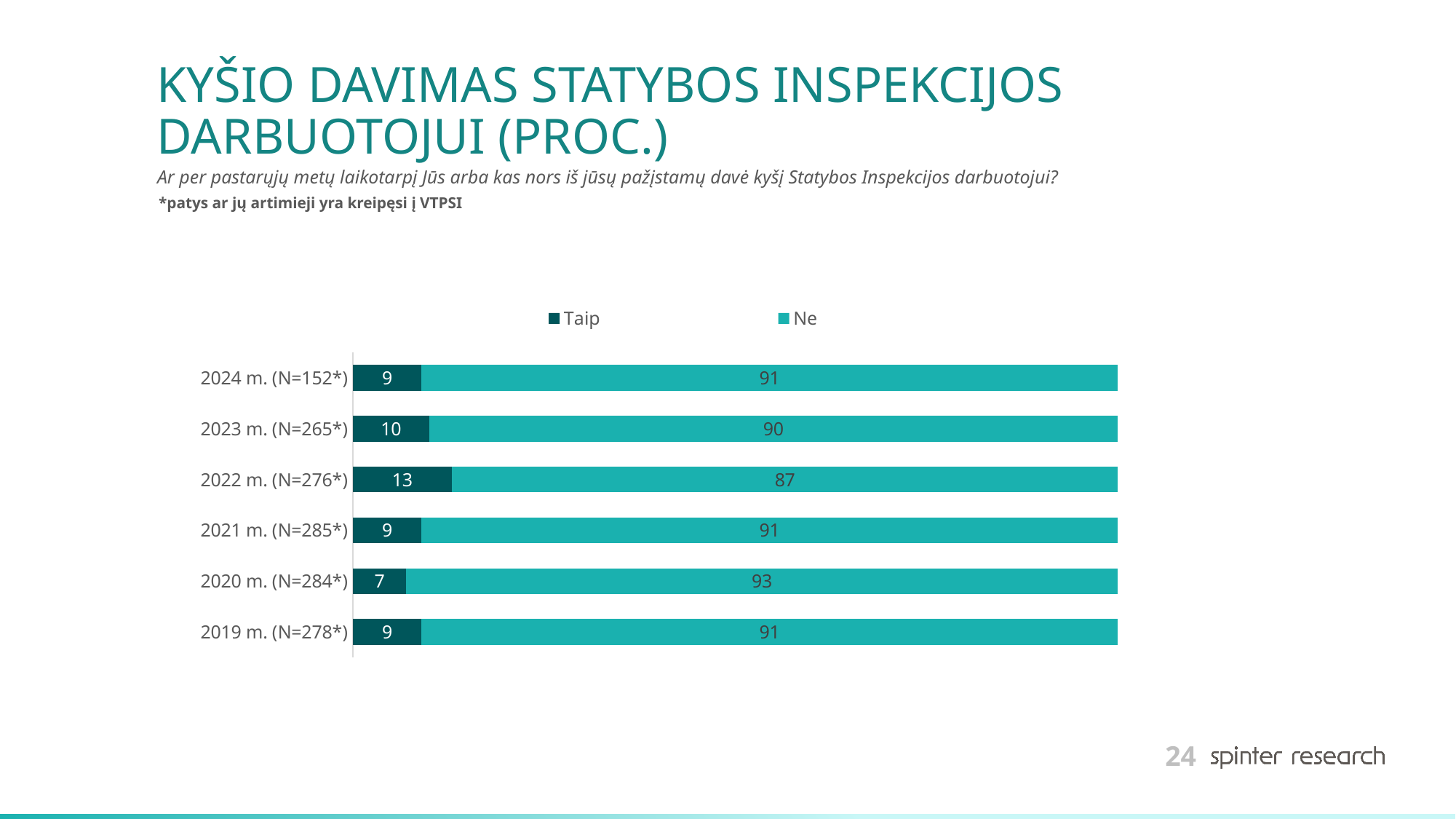
Which is larger: the "Taip" value for 2023 m. (N=265*) or for 2021 m. (N=285*)? 2023 m. (N=265*) What kind of chart is shown on the slide? Stacked bar chart What is the total of the stacked bar for 2023 m. (N=265*)? 100 Which year has the lowest value for "Taip"? 2020 m. (N=284*) What is the value for "Taip" in 2024 m. (N=152*)? 9 What is the difference between the "Ne" values for 2020 m. (N=284*) and 2022 m. (N=276*)? 6 What is the value for "Taip" in 2020 m. (N=284*)? 7 How many series does the legend list? 2 What is the value for "Ne" in 2022 m. (N=276*)? 87 Which year has the highest value for "Ne"? 2020 m. (N=284*) Which year has the highest value for "Taip"? 2022 m. (N=276*) How many years (categories) are shown in the chart? 6